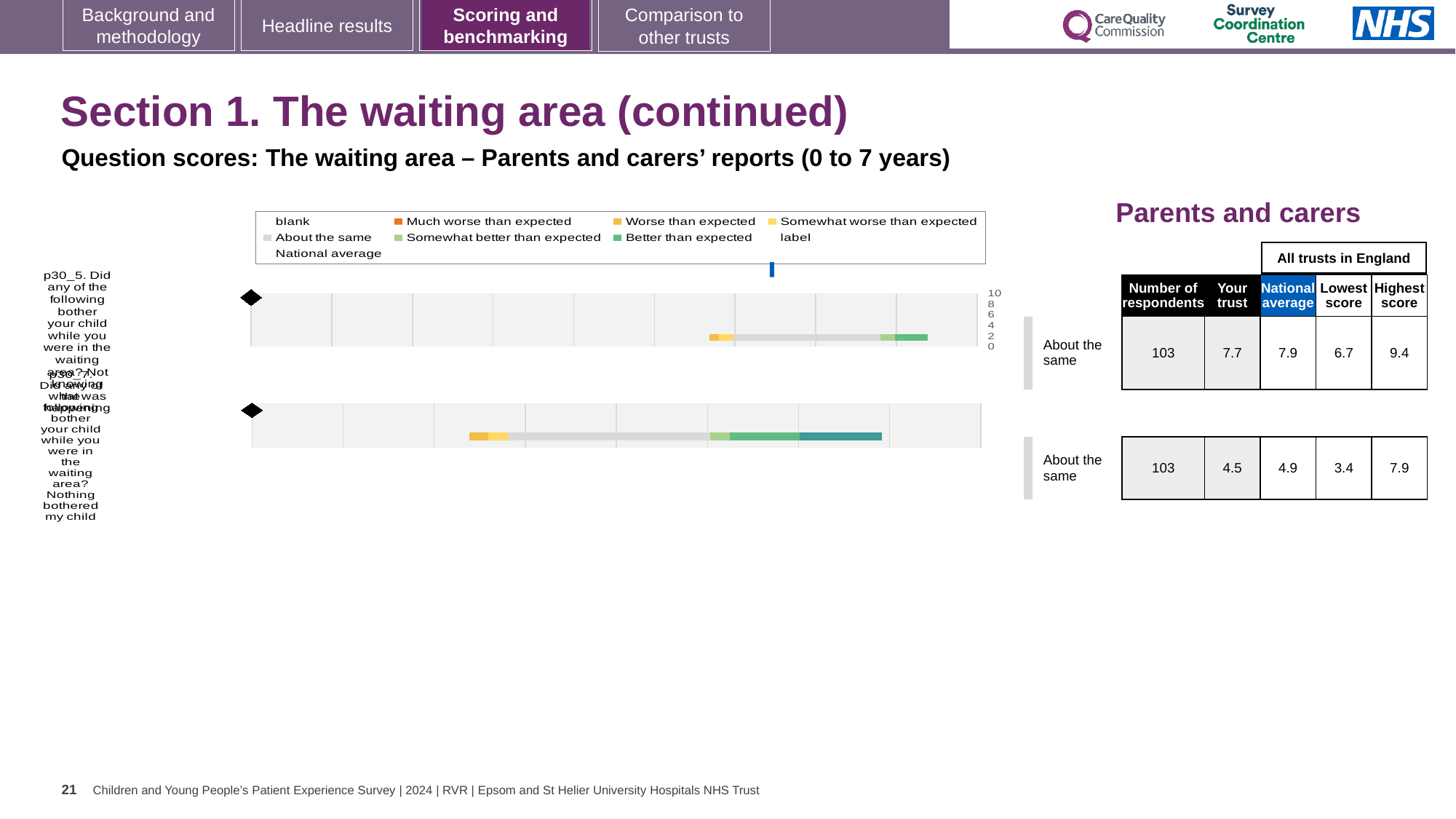
For the bottom chart (p30_7, Nothing bothered my child), what is the 'Your trust' score shown in the table? 4.5 What benchmark category is shown next to both charts? About the same How many benchmark bar charts are shown on the slide? 2 What is the highest tick value shown on the chart's score axis? 10 For the top chart (p30_5), what is the national average score? 7.9 For the bottom chart (p30_7), what is the national average score? 4.9 For the top chart (p30_5), what is the difference between the highest score and the lowest score across all trusts in England? 2.7 What kind of chart is used on this slide to show the question scores? bar chart For the bottom chart (p30_7), what is the difference between the highest score and the lowest score across all trusts in England? 4.5 For the top chart (p30_5, Not knowing what was happening), what is the 'Your trust' score shown in the table? 7.7 How many entries does the chart legend list? 9 For the top chart (p30_5), which is larger: the 'Your trust' score or the national average? National average